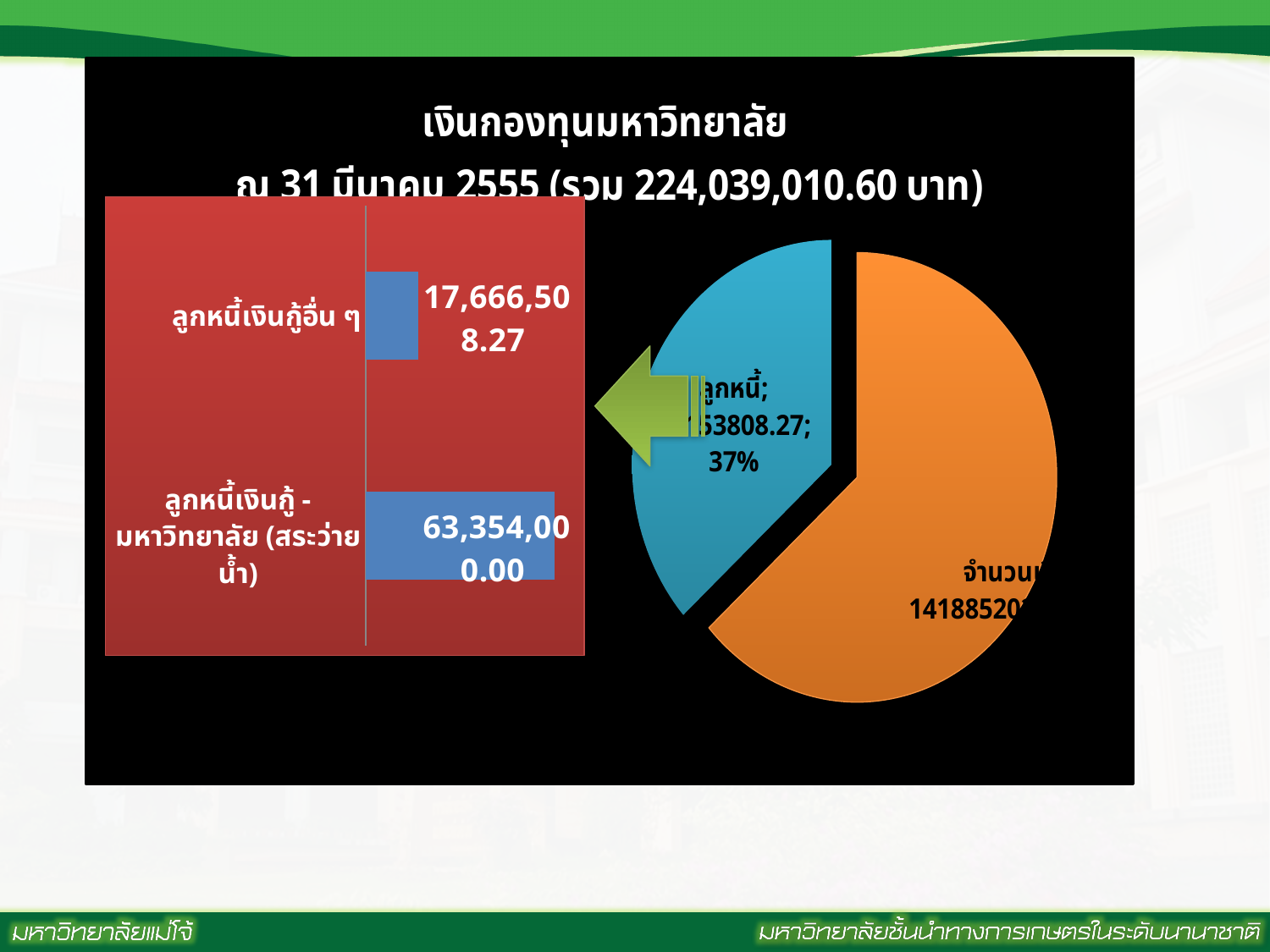
What kind of chart is the chart on the left of the slide? bar chart In the bar chart on the left, which category has the highest value? ลูกหนี้เงินกู้ - มหาวิทยาลัย (สระว่ายน้ำ) In the bar chart on the left, which category has the lowest value? ลูกหนี้เงินกู้อื่น ๆ In the bar chart on the left, which is larger: the value for ลูกหนี้เงินกู้อื่น ๆ or the value for ลูกหนี้เงินกู้ - มหาวิทยาลัย (สระว่ายน้ำ)? ลูกหนี้เงินกู้ - มหาวิทยาลัย (สระว่ายน้ำ) In the pie chart on the right, what share of the pie does the blue slice (ลูกหนี้) represent? 37% In the bar chart on the left, what is the value for ลูกหนี้เงินกู้ - มหาวิทยาลัย (สระว่ายน้ำ)? 63,354,000.00 In the bar chart on the left, what is the value for ลูกหนี้เงินกู้อื่น ๆ? 17,666,508.27 What kind of chart is the chart on the right of the slide? pie chart In the bar chart on the left, what is the difference between the value for ลูกหนี้เงินกู้ - มหาวิทยาลัย (สระว่ายน้ำ) and the value for ลูกหนี้เงินกู้อื่น ๆ? 45,687,491.73 How many categories are shown in the bar chart on the left? 2 How many slices does the pie chart on the right have? 2 According to the slide title, what is the total amount (รวม) of เงินกองทุนมหาวิทยาลัย as of 31 มีนาคม 2555? 224,039,010.60 บาท